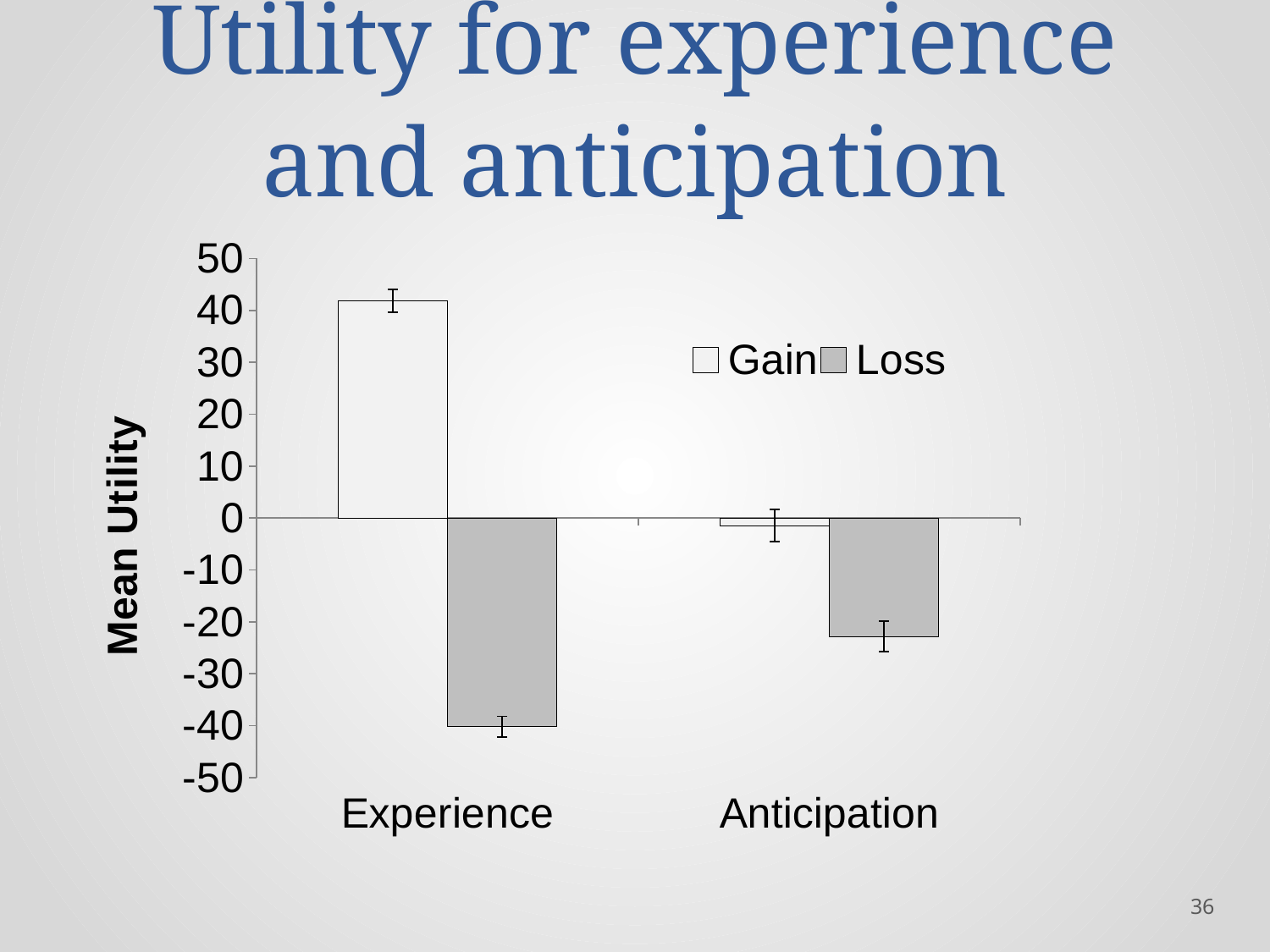
Which series names are listed in the legend? Gain and Loss Which bar has the lowest mean utility? Loss for Experience Which bar has the highest mean utility? Gain for Experience Which is larger, the Gain value for Experience or the Gain value for Anticipation? Experience What kind of chart is shown on the slide? bar chart Is the Loss value for Experience greater or less than -30? less Is the Gain value for Experience greater or less than 30? greater How many series does the legend list? 2 How many categories are shown on the x axis? 2 Is the Loss value for Anticipation greater or less than -10? less Which is larger, the Loss value for Experience or the Loss value for Anticipation? Anticipation What is the title of the y axis? Mean Utility